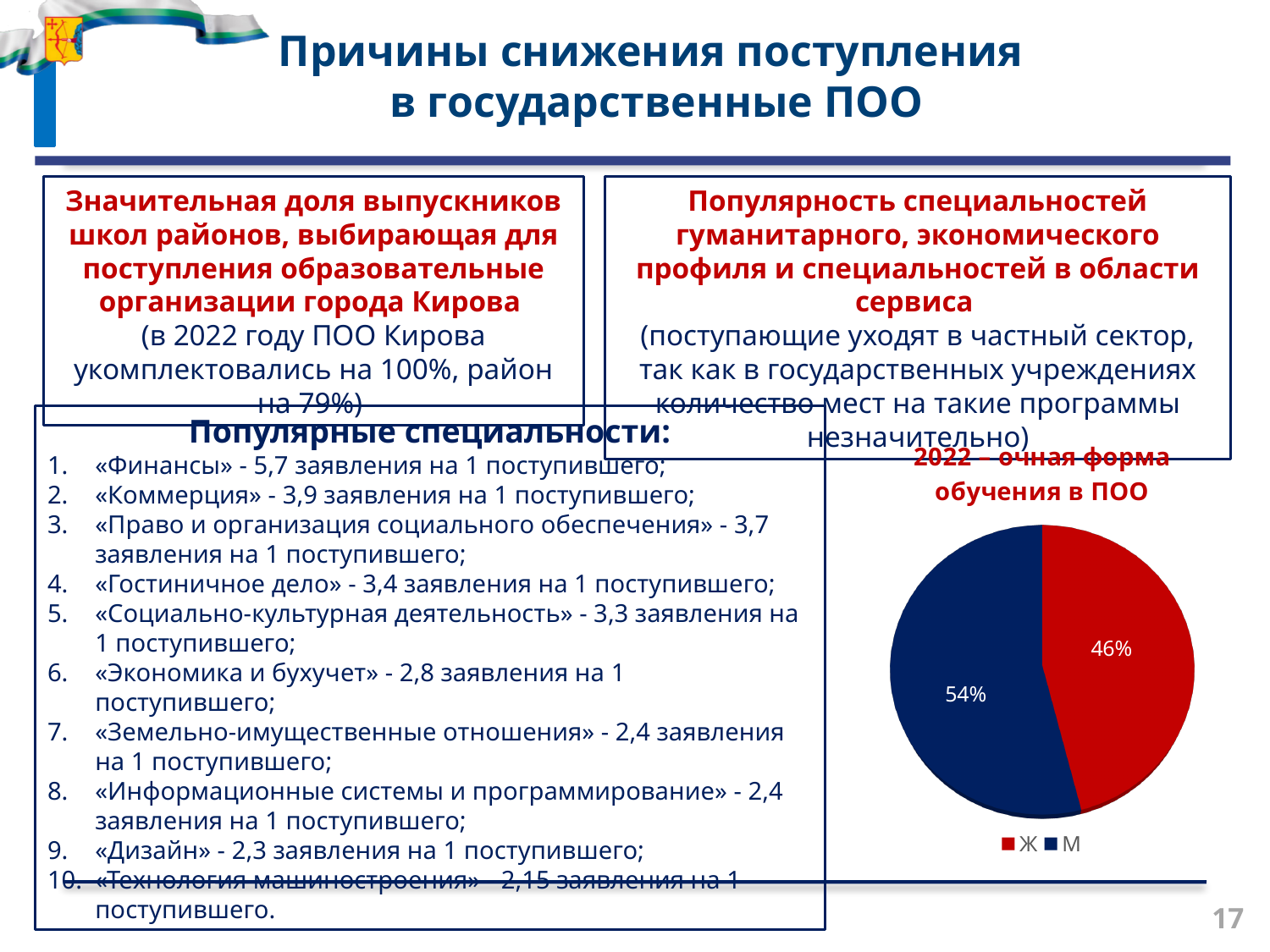
What colour is the Ж slice in the pie chart? red What share of the pie does the Ж slice represent? 46% What share of the pie does the М slice represent? 54% Which is larger in the pie chart, Ж or М? М Which slice of the pie chart is the largest? М What is the difference in percentage points between the М and Ж slices? 8 Which slice of the pie chart is the smallest? Ж How many slices does the pie chart have? 2 What type of chart is shown on the slide? pie chart How many entries does the legend of the pie chart list? 2 What is the title of the pie chart? 2022 – очная форма обучения в ПОО Is the value for М greater or less than 50%? greater